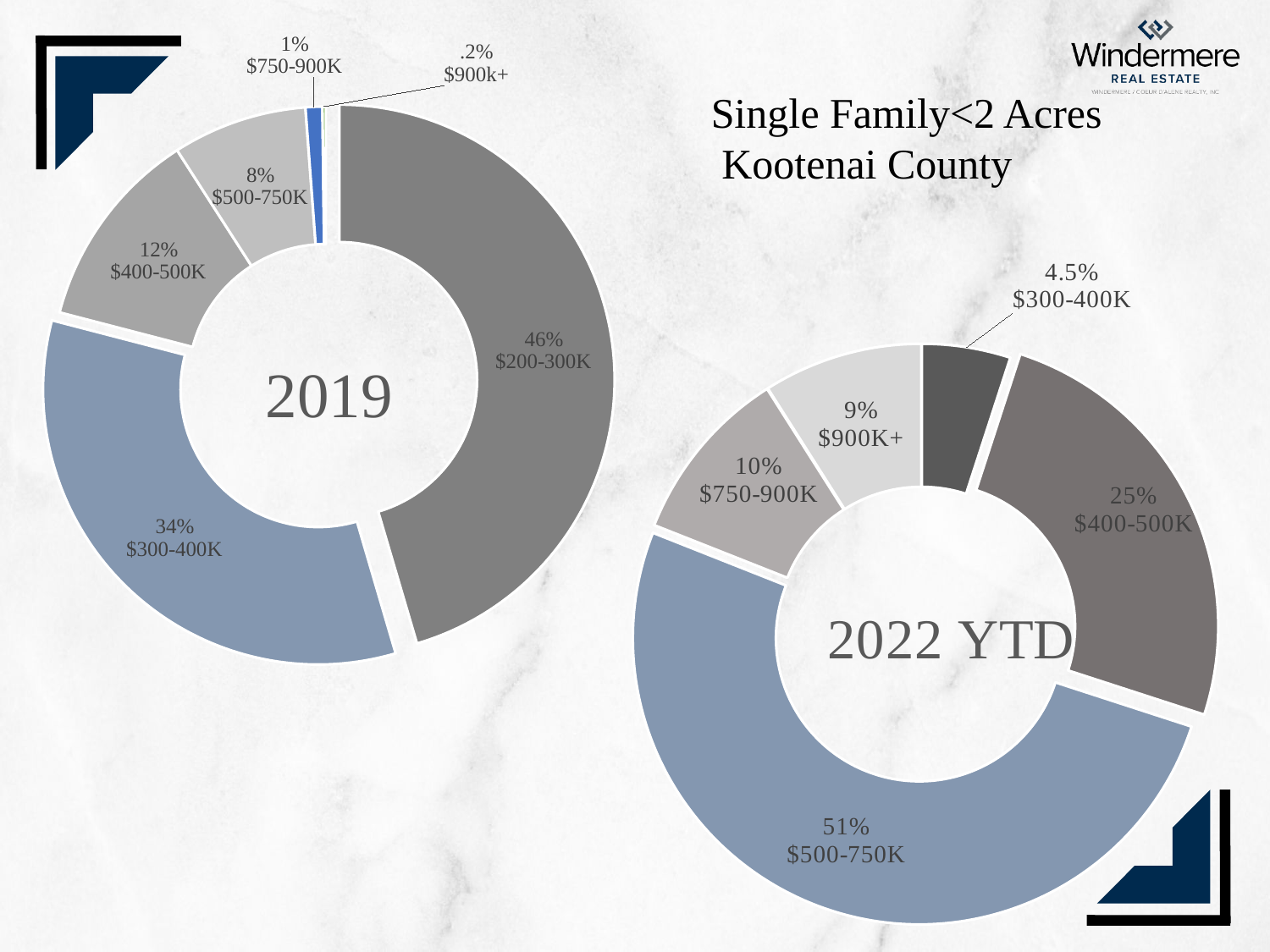
In the 2022 YTD chart, what percentage is shown for the $300-400K range? 4.5% In the 2022 YTD chart, what share is shown for the $500-750K range? 51% What kind of chart is used for the 2019 data? Doughnut (pie) chart What is the title shown on the slide above the charts? Single Family<2 Acres Kootenai County In the 2022 YTD chart, which price range has the largest share? $500-750K In the 2022 YTD chart, which is larger, the $750-900K share or the $900K+ share? $750-900K How many price-range segments does the 2022 YTD chart show? 5 In the 2019 chart, what percentage is shown for the $400-500K range? 12% In the 2019 chart, what share of sales was in the $200-300K range? 46% In the 2019 chart, what is the difference in percentage points between the $200-300K and $300-400K shares? 12 In the 2019 chart, what percentage is shown for the $900k+ range? .2% In the 2019 chart, which price range has the smallest share? $900k+